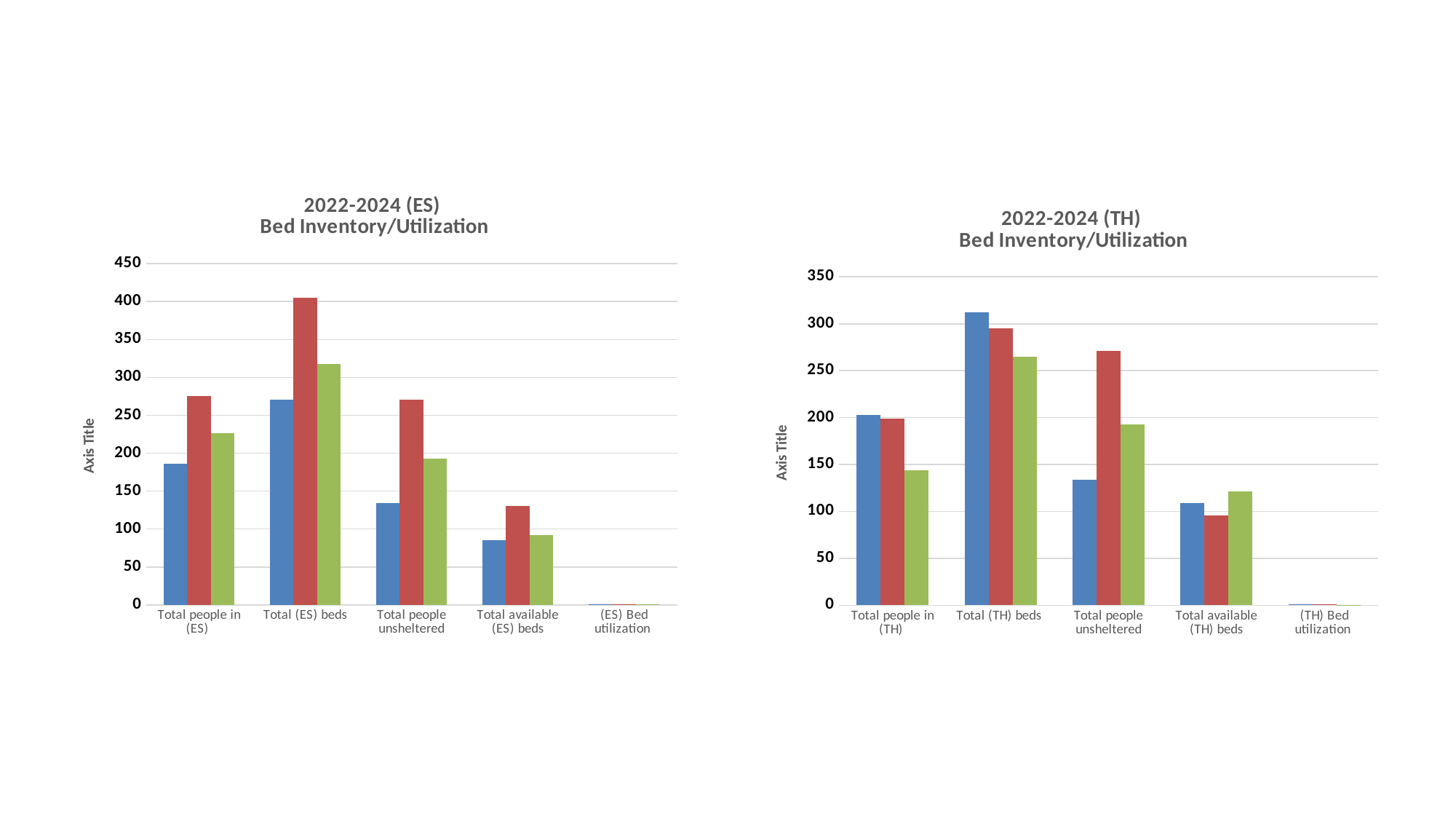
In the 2022-2024 (ES) Bed Inventory/Utilization chart, is the red bar for Total (ES) beds greater or less than 350? greater In the 2022-2024 (TH) Bed Inventory/Utilization chart, is the blue bar for Total (TH) beds greater or less than 300? greater In the 2022-2024 (ES) Bed Inventory/Utilization chart, for Total people unsheltered, is the red bar or the blue bar larger? red bar In the 2022-2024 (TH) Bed Inventory/Utilization chart, is the green bar for Total people in (TH) greater or less than 150? less What is the y-axis title shown on the 2022-2024 (TH) Bed Inventory/Utilization chart? Axis Title In the 2022-2024 (ES) Bed Inventory/Utilization chart, which category has the tallest red bar? Total (ES) beds In the 2022-2024 (TH) Bed Inventory/Utilization chart, for Total people in (TH), is the blue bar or the green bar larger? blue bar In the 2022-2024 (ES) Bed Inventory/Utilization chart, which category has the lowest bars overall? (ES) Bed utilization What kind of chart is the 2022-2024 (ES) Bed Inventory/Utilization chart? bar chart How many categories are shown on the x axis of the 2022-2024 (TH) Bed Inventory/Utilization chart? 5 In the 2022-2024 (TH) Bed Inventory/Utilization chart, which category has the tallest blue bar? Total (TH) beds